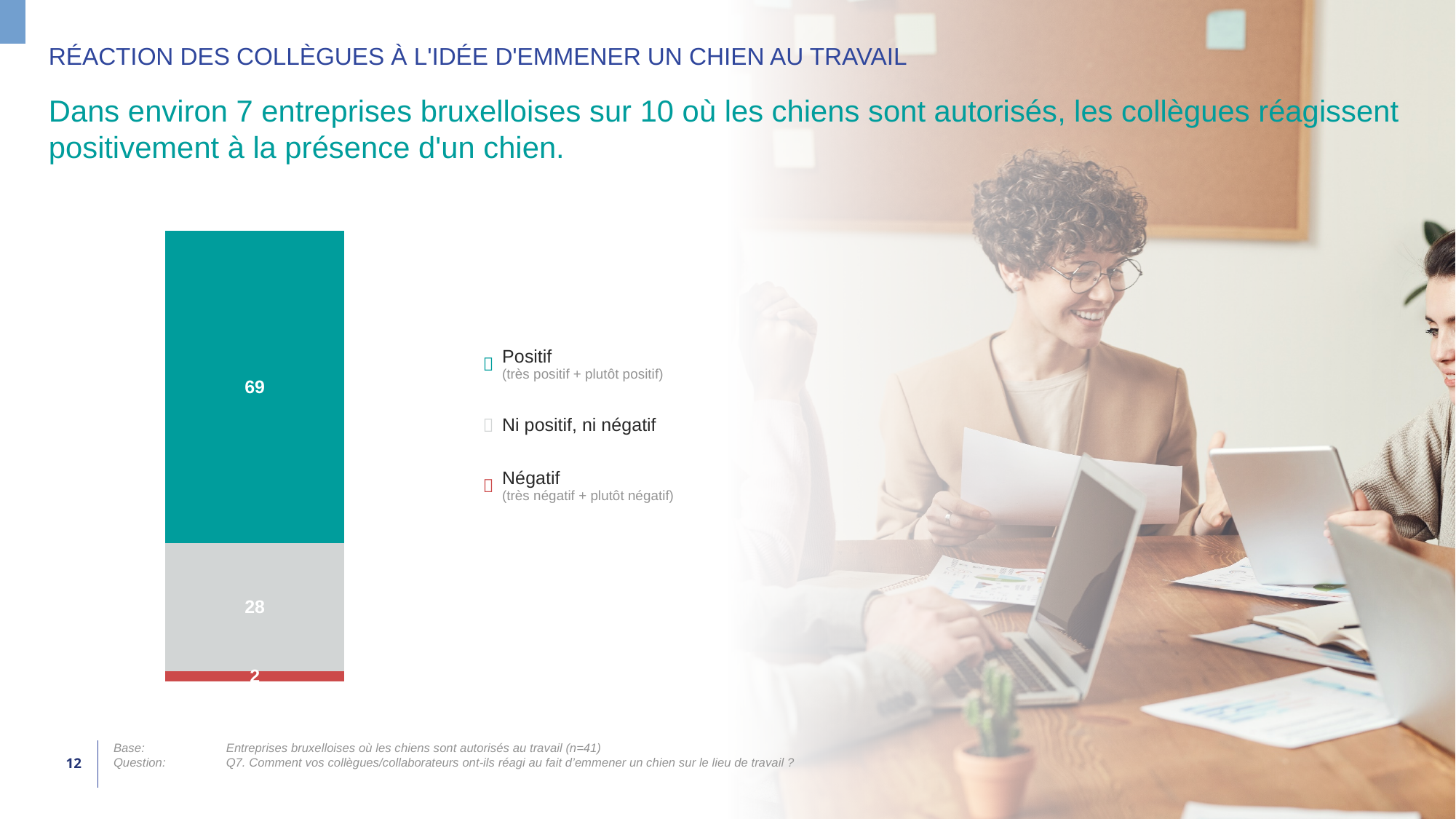
Which segment of the stacked bar has the lowest value? Négatif What value is shown for the Négatif segment of the bar? 2 How many entries does the legend list? 3 What is the difference between the Positif value and the Ni positif, ni négatif value? 41 What value is shown for the Ni positif, ni négatif segment? 28 What value is shown for the Positif segment of the stacked bar? 69 Which segment of the stacked bar has the highest value? Positif How many segments make up the stacked bar? 3 What type of chart is shown on the slide? Stacked bar chart What is the total of the three segments in the stacked bar? 99 Which is larger, the Positif value or the Négatif value? Positif What is the difference between the Ni positif, ni négatif value and the Négatif value? 26